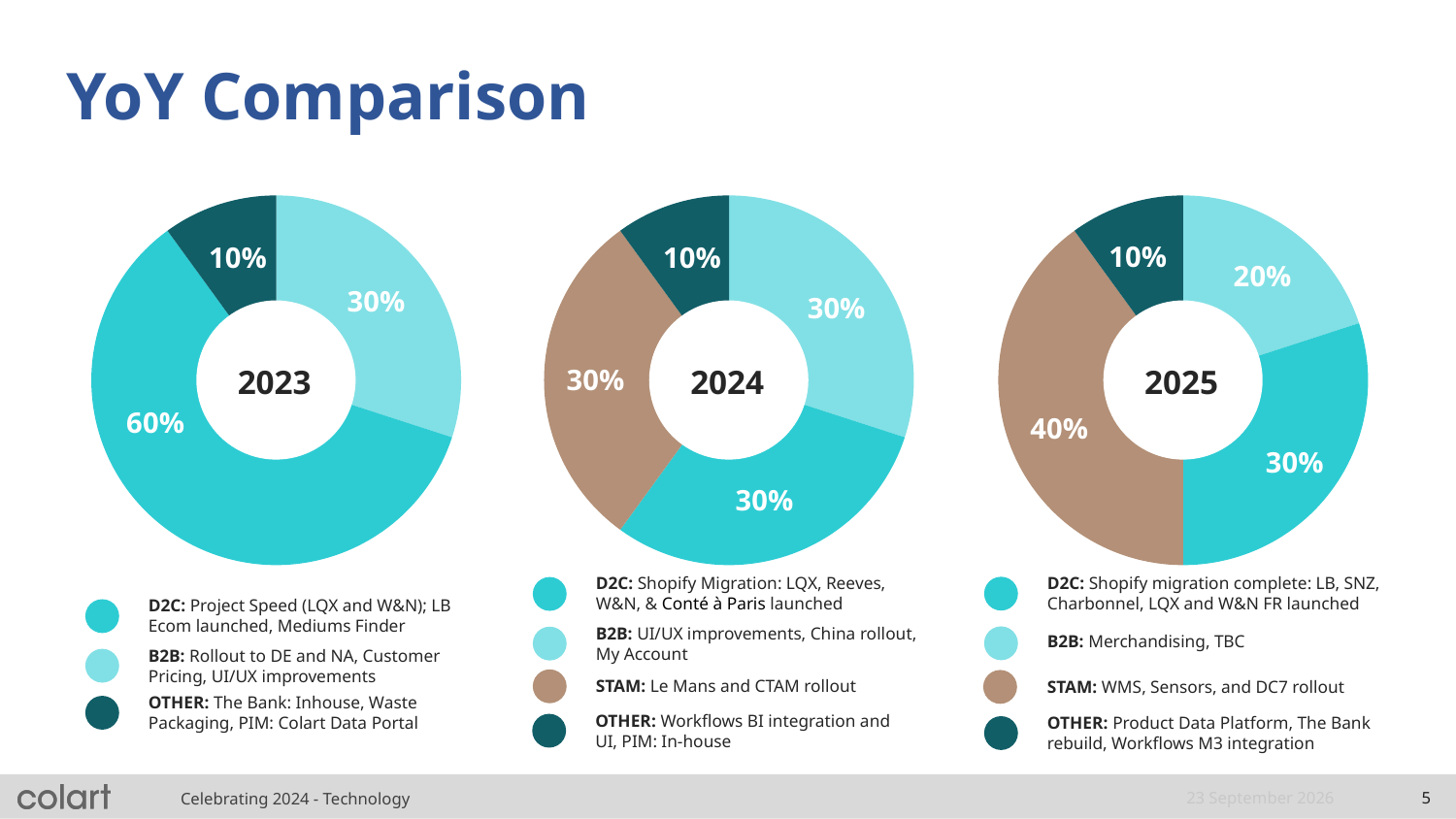
What kind of chart is used for each year on the slide? Pie (donut) chart In the 2023 chart, which category has the smallest share? OTHER In the 2024 chart, what share does OTHER have? 10% In the 2023 chart, what share does D2C have? 60% In the 2025 chart, what is the difference between the STAM share and the D2C share? 10% In the 2023 chart, how many slices are there? 3 In the 2024 chart, what share does STAM have? 30% In the 2025 chart, what share does B2B have? 20% In the 2025 chart, which category has the largest share? STAM In the 2024 chart, how many categories does the legend list? 4 In the 2025 chart, which is larger, the D2C share or the B2B share? D2C In the 2023 chart, what share does B2B have? 30%